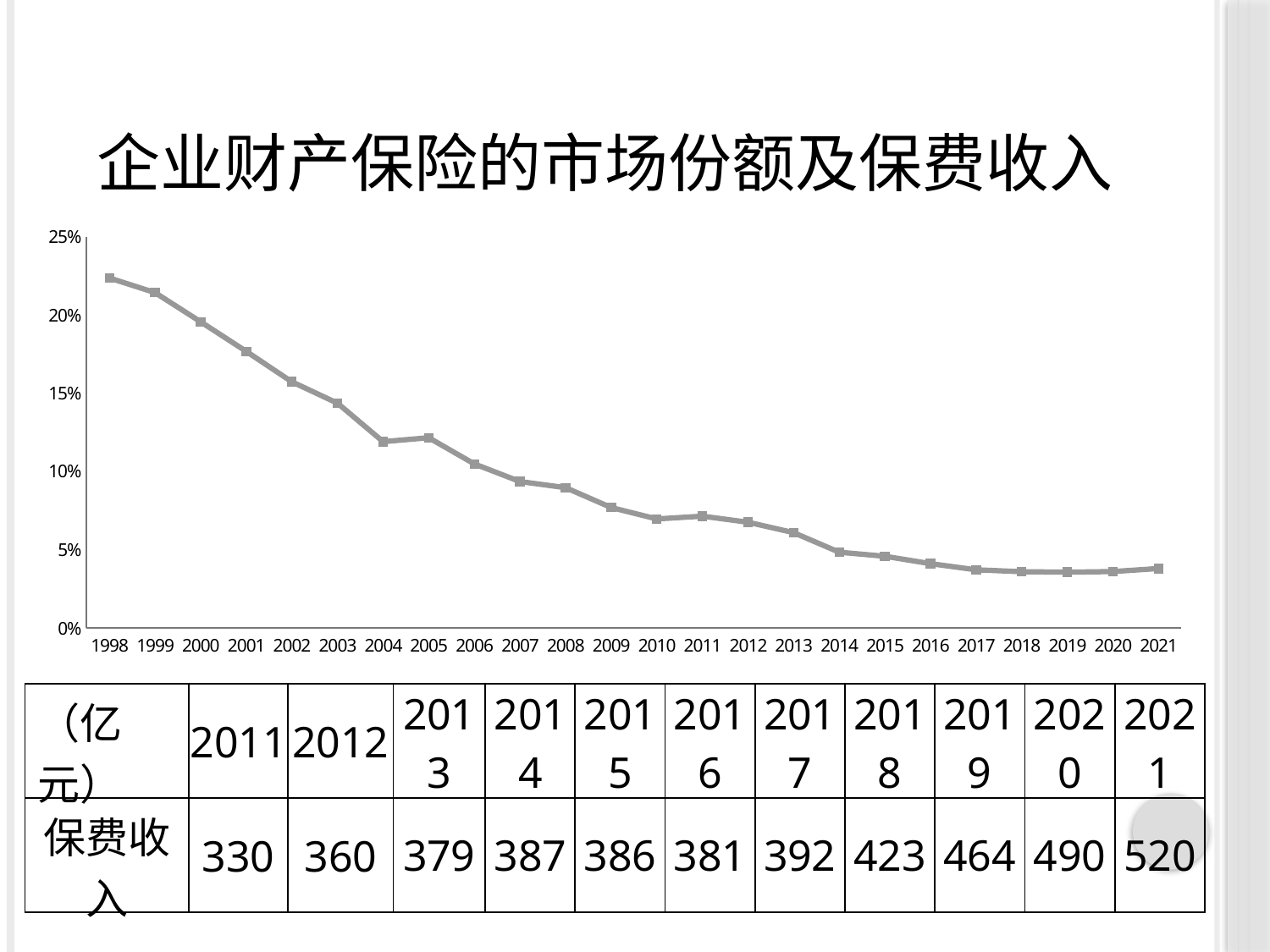
Is the value for 2017 greater or less than 5%? less Is the value for 2004 greater or less than 10%? greater What is the first year shown on the x axis of the chart? 1998 Do the values in the chart generally rise or fall from 1998 to 2021? fall Which is larger, the value for 2000 or the value for 2010? 2000 Which year has the highest value in the chart? 1998 Is the value for 2010 greater or less than 5%? greater What kind of chart is shown on the slide? line chart What is the title of the chart? 企业财产保险的市场份额及保费收入 How many years are plotted along the x axis of the chart? 24